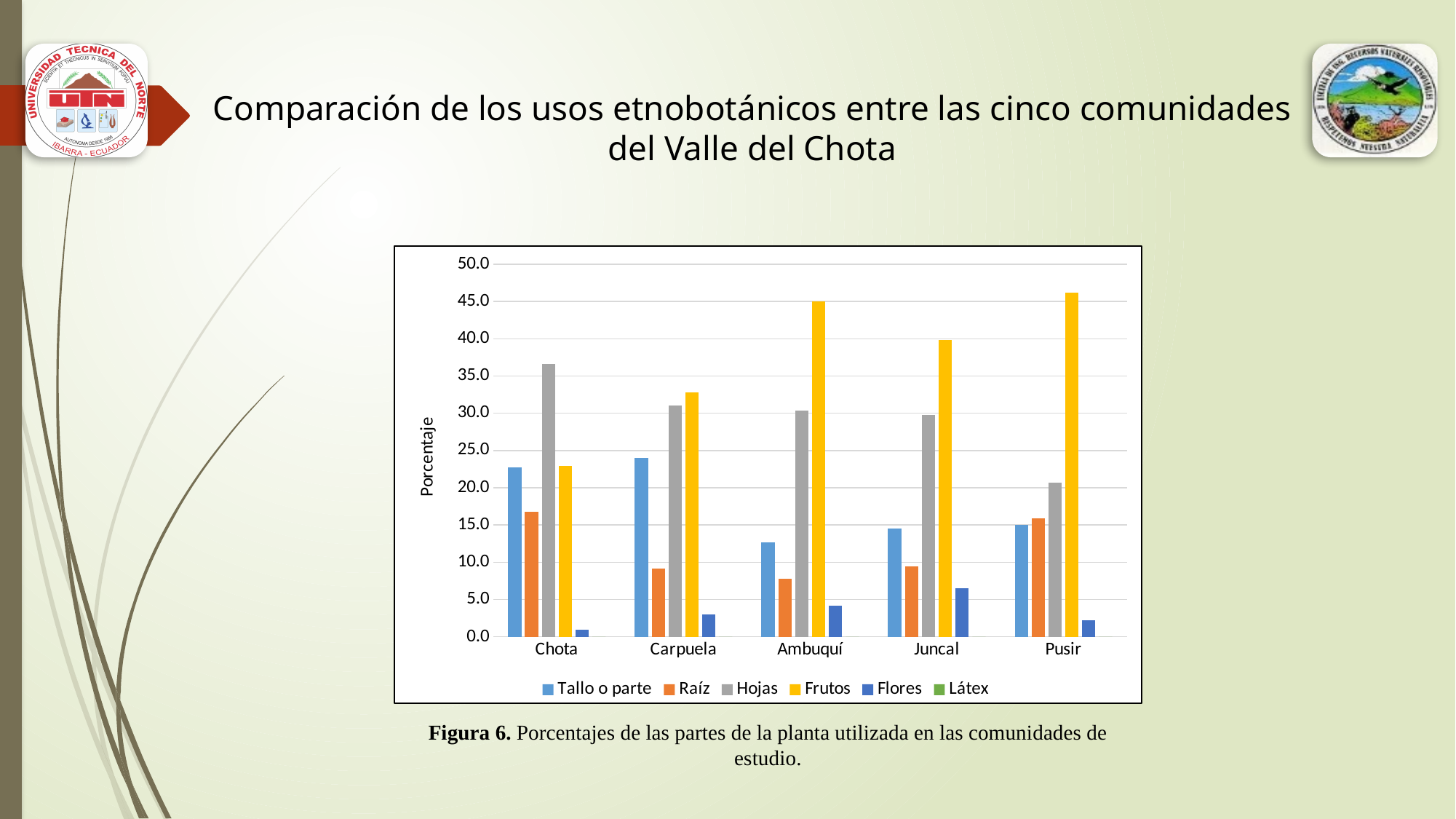
What kind of chart is shown on the slide? bar chart Which community has the highest value for Hojas? Chota Is the value for Frutos in Ambuquí greater or less than 40.0? greater Is the value for Tallo o parte in Carpuela greater or less than 20.0? greater Which community has the lowest value for Flores? Chota How many communities are shown on the x axis of the chart? 5 In Juncal, which is larger: Frutos or Hojas? Frutos Is the value for Raíz in Ambuquí greater or less than 10.0? less How many series does the chart legend list? 6 What is the label of the y axis of the chart? Porcentaje In Chota, which is larger: Hojas or Frutos? Hojas